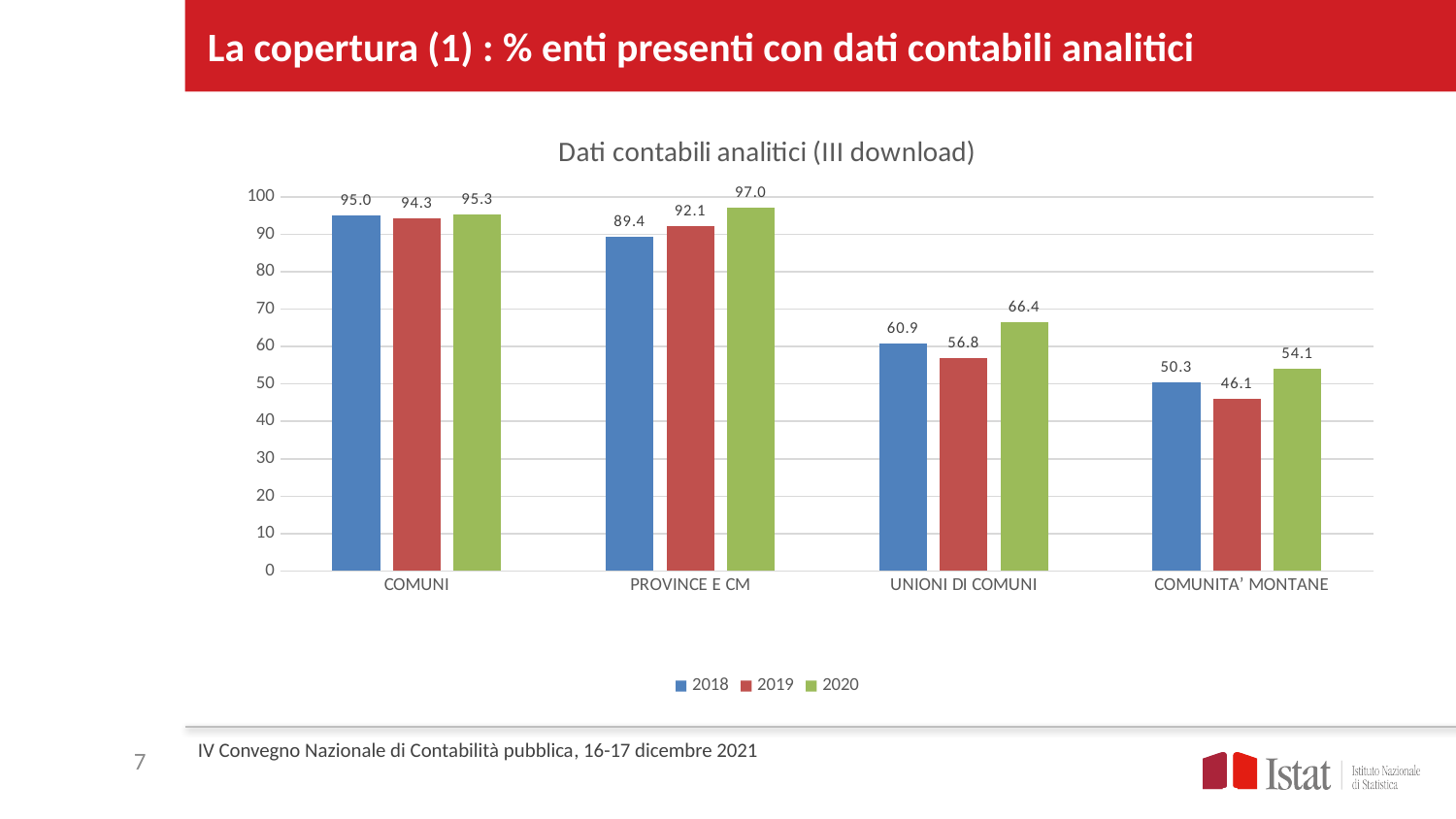
How many categories are shown on the x axis? 4 What is the difference between the 2020 and 2019 values for UNIONI DI COMUNI? 9.6 Which category has the lowest value in 2019? COMUNITA' MONTANE Which category has the highest value in 2020? PROVINCE E CM Which is larger for COMUNI: the 2018 value or the 2019 value? 2018 What is the value for PROVINCE E CM in 2020? 97.0 What is the value for UNIONI DI COMUNI in 2018? 60.9 What is the title of the chart? Dati contabili analitici (III download) What is the value for COMUNITA' MONTANE in 2019? 46.1 How many series does the legend list? 3 What kind of chart is shown? Bar chart Is the value for COMUNITA' MONTANE in 2020 greater or less than 50? greater